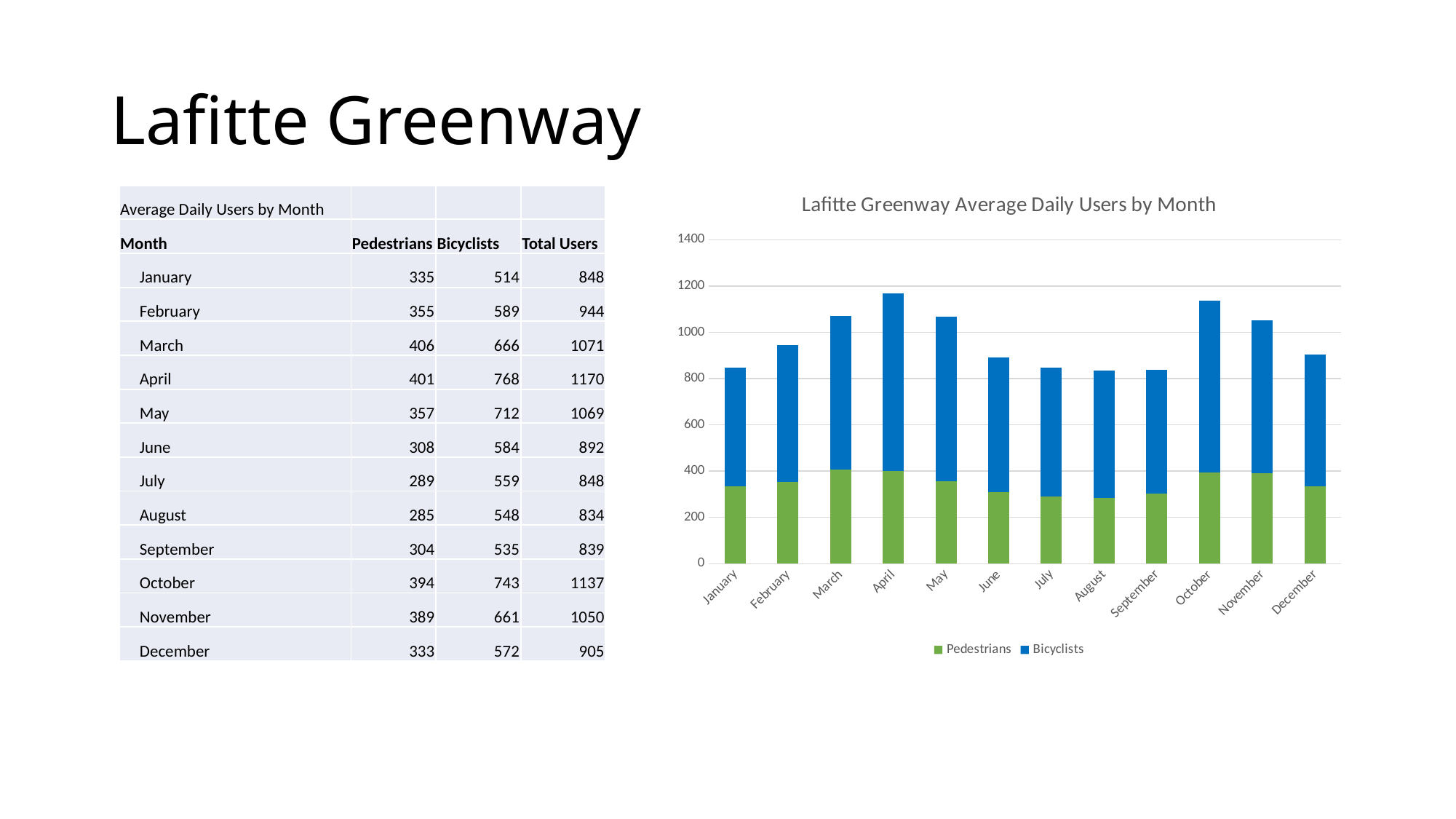
How many months are plotted along the x axis of the chart? 12 What is the Bicyclists value for April? 768 Which colour represents Pedestrians in the chart? green What kind of chart is shown on the slide? bar chart What is the Pedestrians value for October? 394 What is the total of the stacked bar for October? 1137 Is the total stacked bar for August greater or less than 1000? less What is the difference between the Bicyclists value for May and the Bicyclists value for June? 128 Which month has a taller stacked bar, March or July? March Is the total stacked bar for October greater or less than 1000? greater How many series does the chart's legend list? 2 Which month has the tallest stacked bar (highest total users)? April